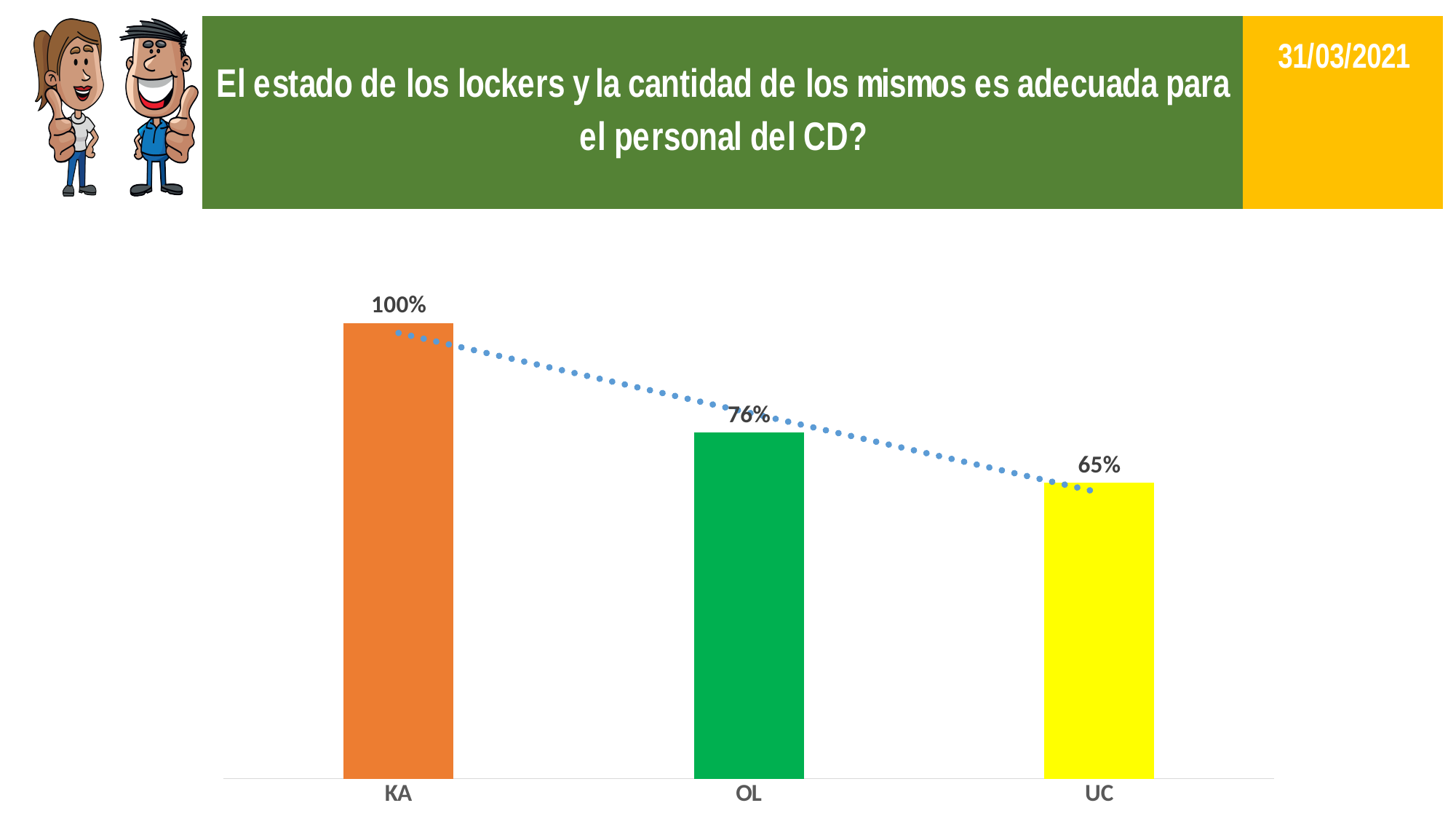
Which category has the lowest value? UC What is the value for KA? 100% Which is larger, the value for OL or the value for UC? OL What colour is the bar for UC? Yellow What is the value for OL? 76% Do the values rise or fall from KA to UC along the x axis? Fall Which category has the highest value? KA What is the value for UC? 65% What is the difference between the values for OL and UC? 11% How many categories are shown on the chart? 3 What is the difference between the values for KA and OL? 24% What kind of chart is shown on the slide? Bar chart